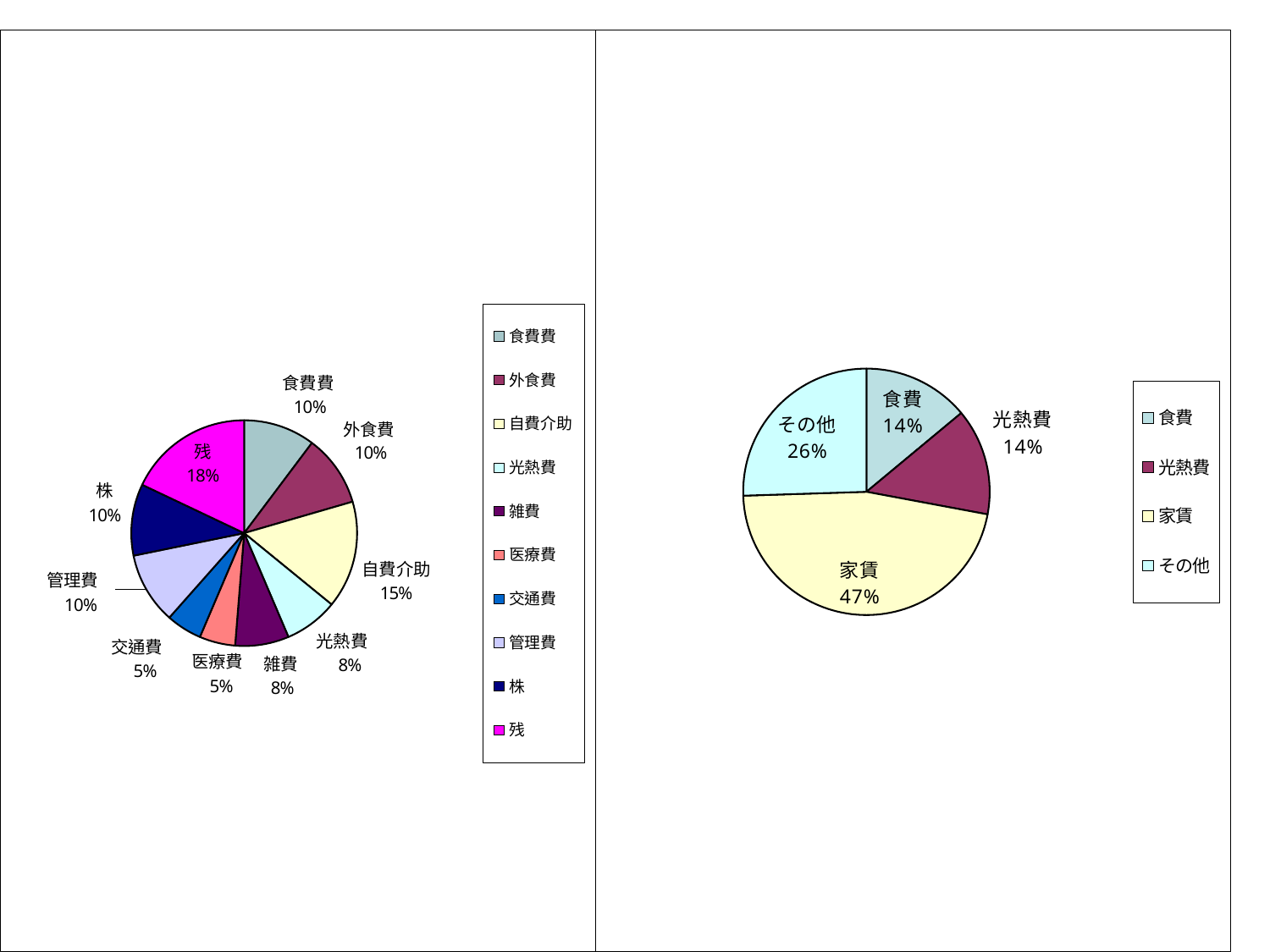
On the right pie chart, what share does 家賃 have? 47% How many categories does the right pie chart show? 4 On the left pie chart, which is larger, 自費介助 or 光熱費? 自費介助 On the left pie chart, what share does 自費介助 have? 15% On the left pie chart, what share does 残 have? 18% On the left pie chart, which category has the largest share? 残 On the left pie chart, what is the difference between the shares of 残 and 医療費? 13% How many categories does the left pie chart show? 10 What kind of chart is the right chart? Pie chart On the right pie chart, which category has the largest share? 家賃 On the right pie chart, what is the difference between the shares of 家賃 and その他? 21% How many entries does the legend of the left chart list? 10